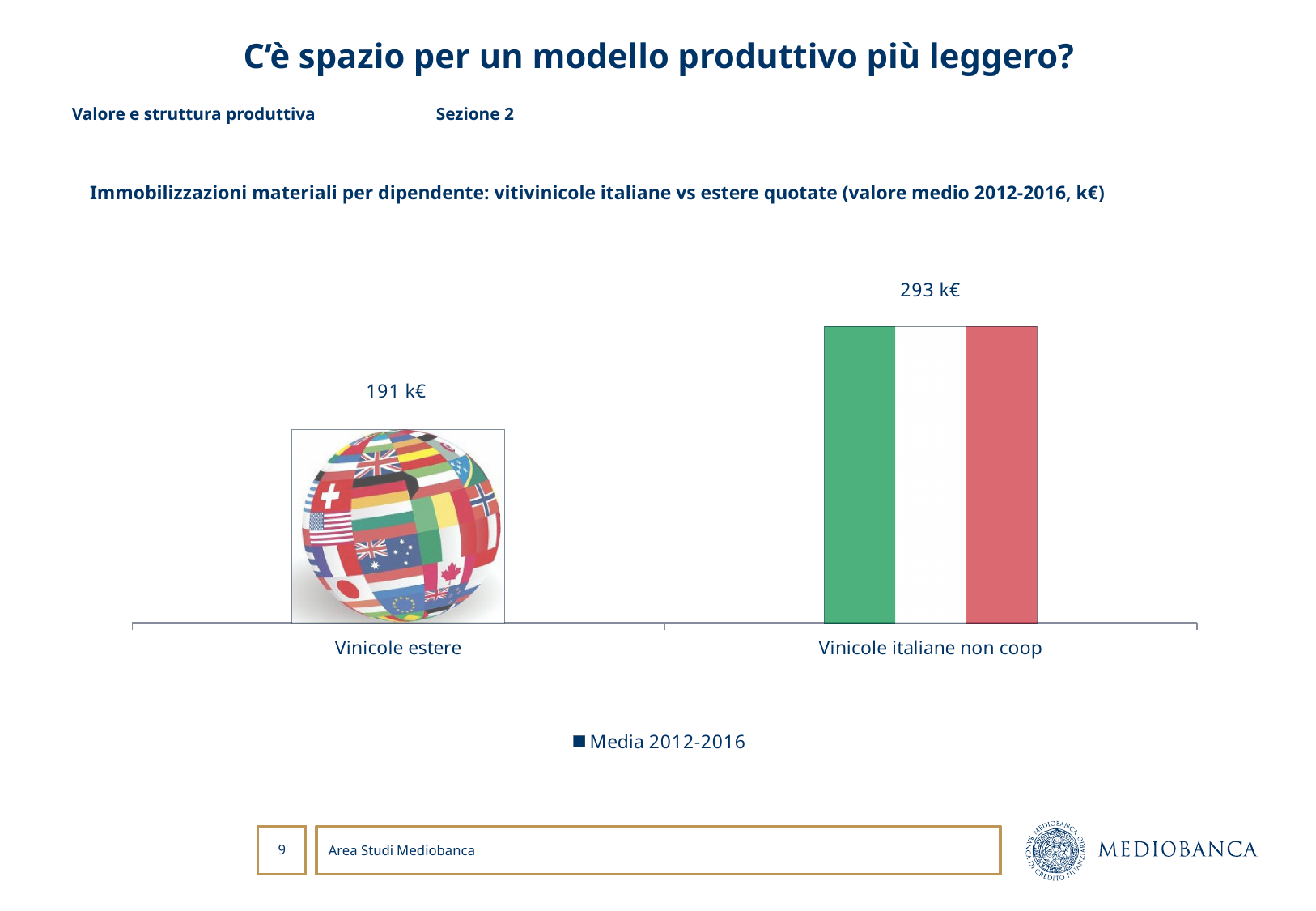
How many categories are shown on the x axis? 2 How many series does the legend list? 1 Which is larger, the value for Vinicole estere or the value for Vinicole italiane non coop? Vinicole italiane non coop What is the difference between the values for Vinicole italiane non coop and Vinicole estere? 102 k€ Which category has the highest value? Vinicole italiane non coop What is the value for Vinicole estere? 191 k€ What kind of chart is shown on the slide? Bar chart What is the legend entry of the chart? Media 2012-2016 What is the title of the chart? Immobilizzazioni materiali per dipendente: vitivinicole italiane vs estere quotate (valore medio 2012-2016, k€) What is the value for Vinicole italiane non coop? 293 k€ Which category has the lowest value? Vinicole estere